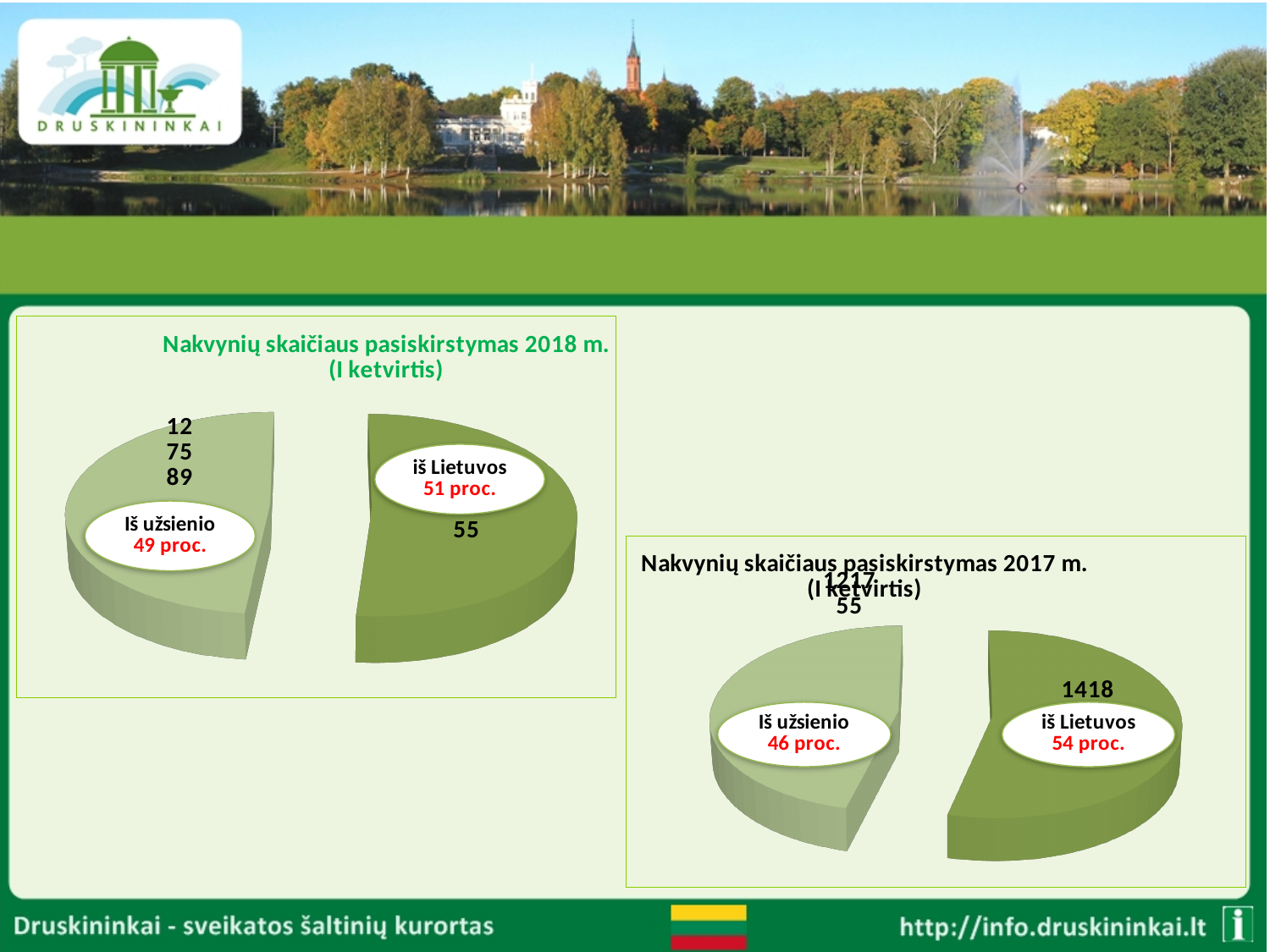
In the 2018 m. (I ketvirtis) chart, what share of the pie is 'Iš užsienio'? 49 proc. In the 2017 m. (I ketvirtis) chart, which slice is the largest? iš Lietuvos In the 2017 m. (I ketvirtis) chart, which slice is larger, 'iš Lietuvos' or 'Iš užsienio'? iš Lietuvos In the 2017 m. (I ketvirtis) chart, what is the difference in percentage points between the 'iš Lietuvos' and 'Iš užsienio' shares? 8 proc. In the 2017 m. (I ketvirtis) chart, what share of the pie is 'Iš užsienio'? 46 proc. How many slices does the 2017 m. (I ketvirtis) pie chart have? 2 In the 2017 m. (I ketvirtis) chart, what share of the pie is 'iš Lietuvos'? 54 proc. What type of chart is the 2018 m. (I ketvirtis) chart on the left? pie chart In the 2018 m. (I ketvirtis) chart, which slice is the smallest? Iš užsienio What is the title of the chart on the left of the slide? Nakvynių skaičiaus pasiskirstymas 2018 m. (I ketvirtis) In the 2017 m. (I ketvirtis) chart, what value is printed on the 'iš Lietuvos' slice? 1418